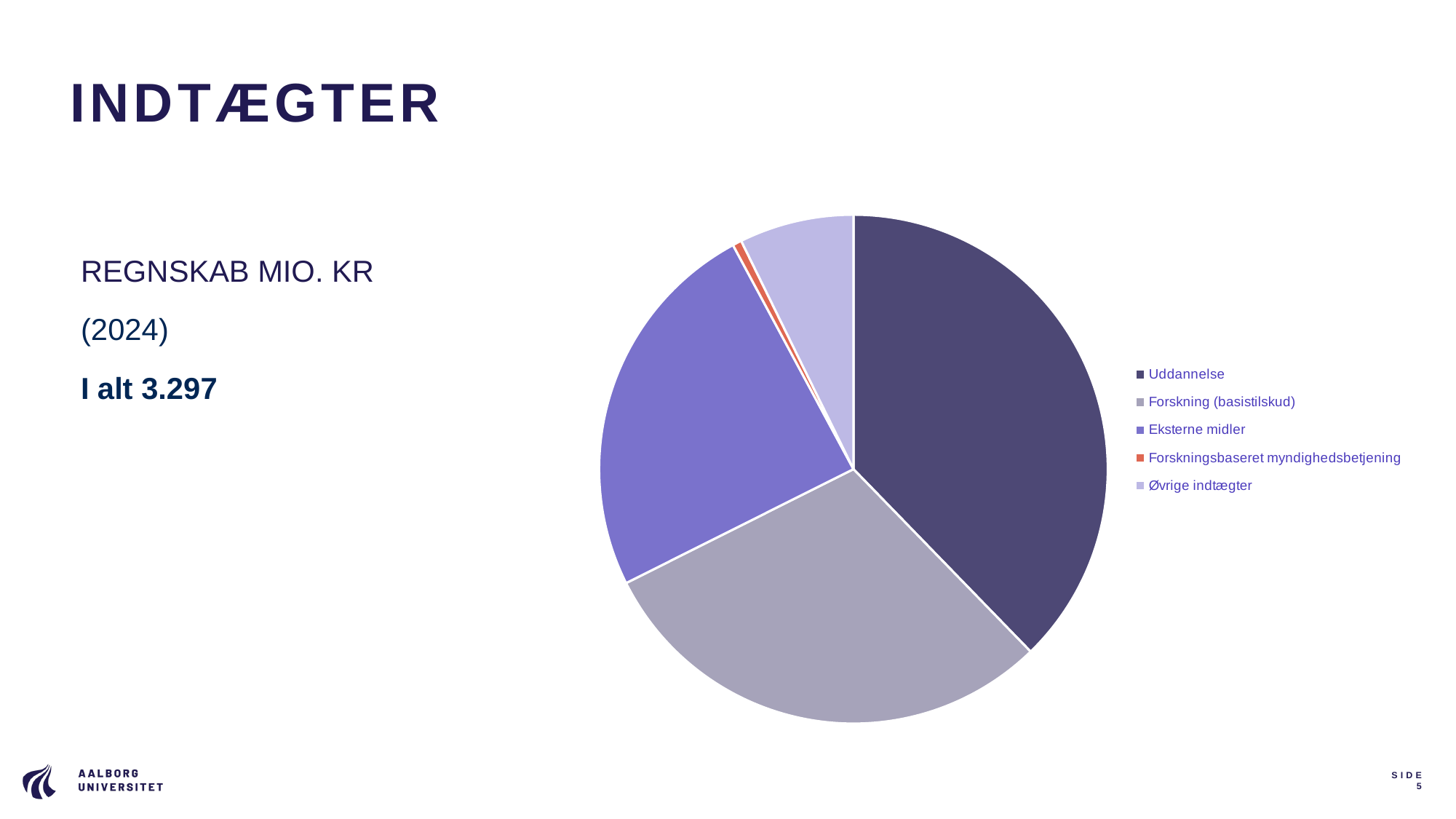
Which category has the smallest slice of the pie chart? Forskningsbaseret myndighedsbetjening Which slice is larger, Eksterne midler or Forskningsbaseret myndighedsbetjening? Eksterne midler Which slice is larger, Uddannelse or Øvrige indtægter? Uddannelse What kind of chart is shown on the slide? Pie chart What total amount is stated on the slide for the income shown in the pie chart? 3.297 How many entries does the legend of the pie chart list? 5 Which slice is larger, Forskning (basistilskud) or Eksterne midler? Forskning (basistilskud) Which legend entry of the pie chart is shown in red/orange? Forskningsbaseret myndighedsbetjening How many slices does the pie chart have? 5 Which category has the largest slice of the pie chart? Uddannelse